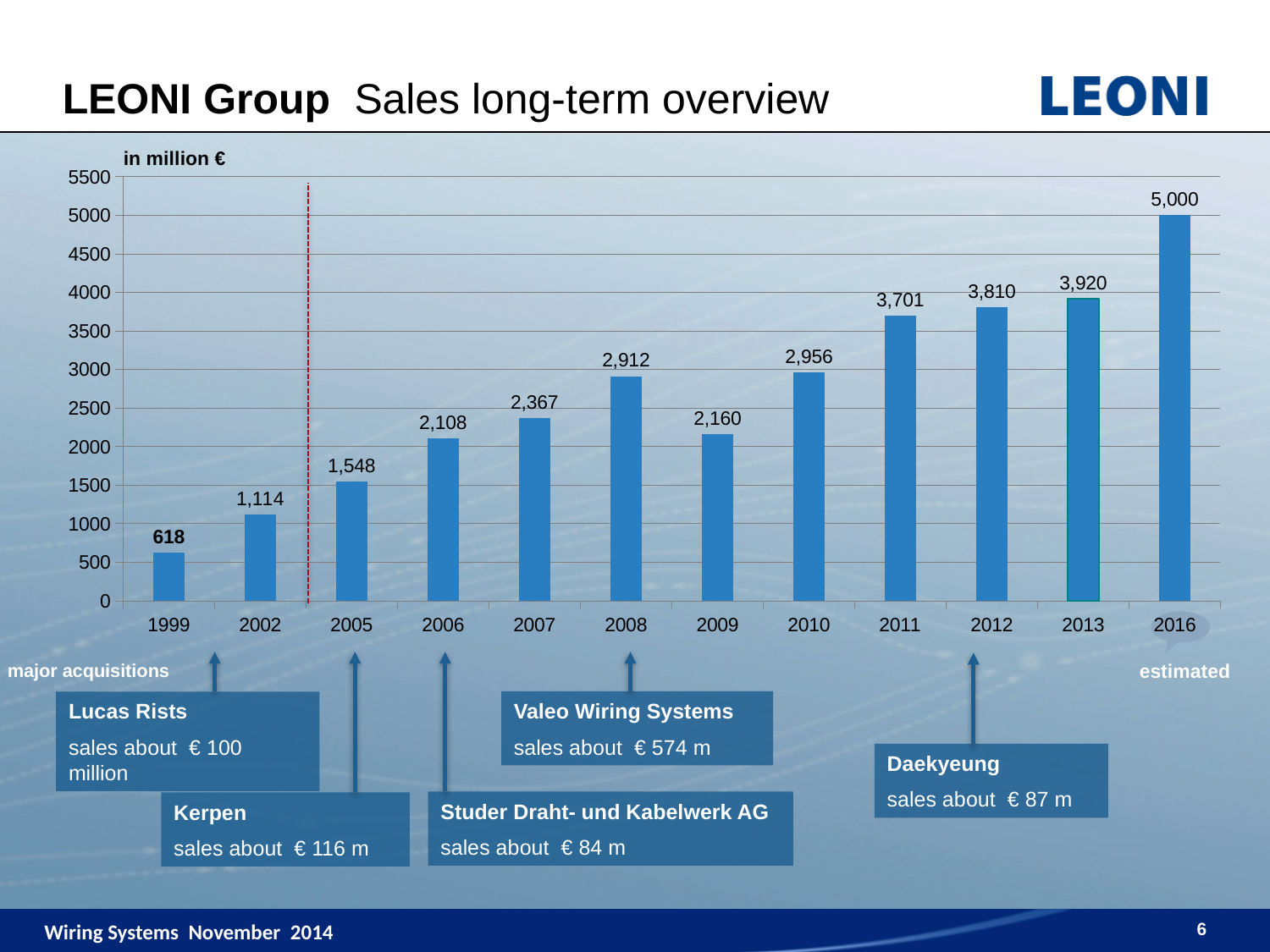
Do the sales values rise or fall from 2010 to 2013? rise Which year has the larger sales value, 2009 or 2010? 2010 In what unit are the sales values on the chart expressed? in million € What is the difference between the sales values for 2013 and 2012? 110 What is the difference between the sales values for 2008 and 2009? 752 What is the estimated sales value shown for 2016? 5,000 What were LEONI Group sales in 2008, in million €? 2,912 What is the sales value shown for 1999? 618 Which year has the lowest sales value on the chart? 1999 What type of chart is shown on the slide? bar chart How many years are shown on the x axis of the chart? 12 Which year has the highest sales value on the chart? 2016